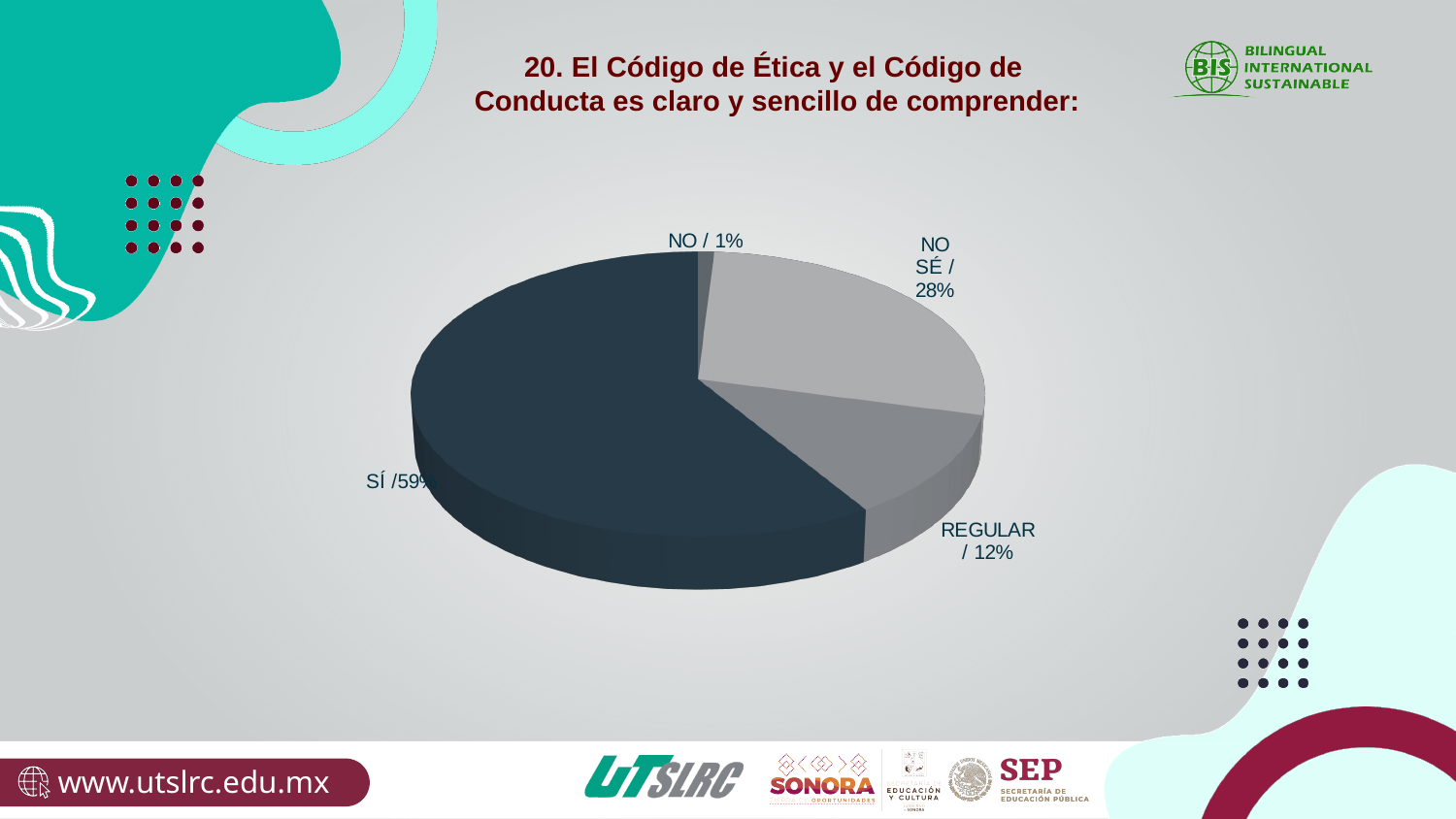
What percentage of responses are "SÍ"? 59% What kind of chart is shown on the slide? Pie chart Which category has the smallest share of the pie? NO What is the difference in percentage points between "SÍ" and "NO SÉ"? 31 Which is larger, the share for "REGULAR" or the share for "NO SÉ"? NO SÉ What is the title of the chart? 20. El Código de Ética y el Código de Conducta es claro y sencillo de comprender: What percentage of responses are "REGULAR"? 12% What percentage of responses are "NO"? 1% What is the combined share of "REGULAR" and "NO"? 13% How many slices does the pie chart have? 4 Which category has the largest share of the pie? SÍ What percentage of responses are "NO SÉ"? 28%